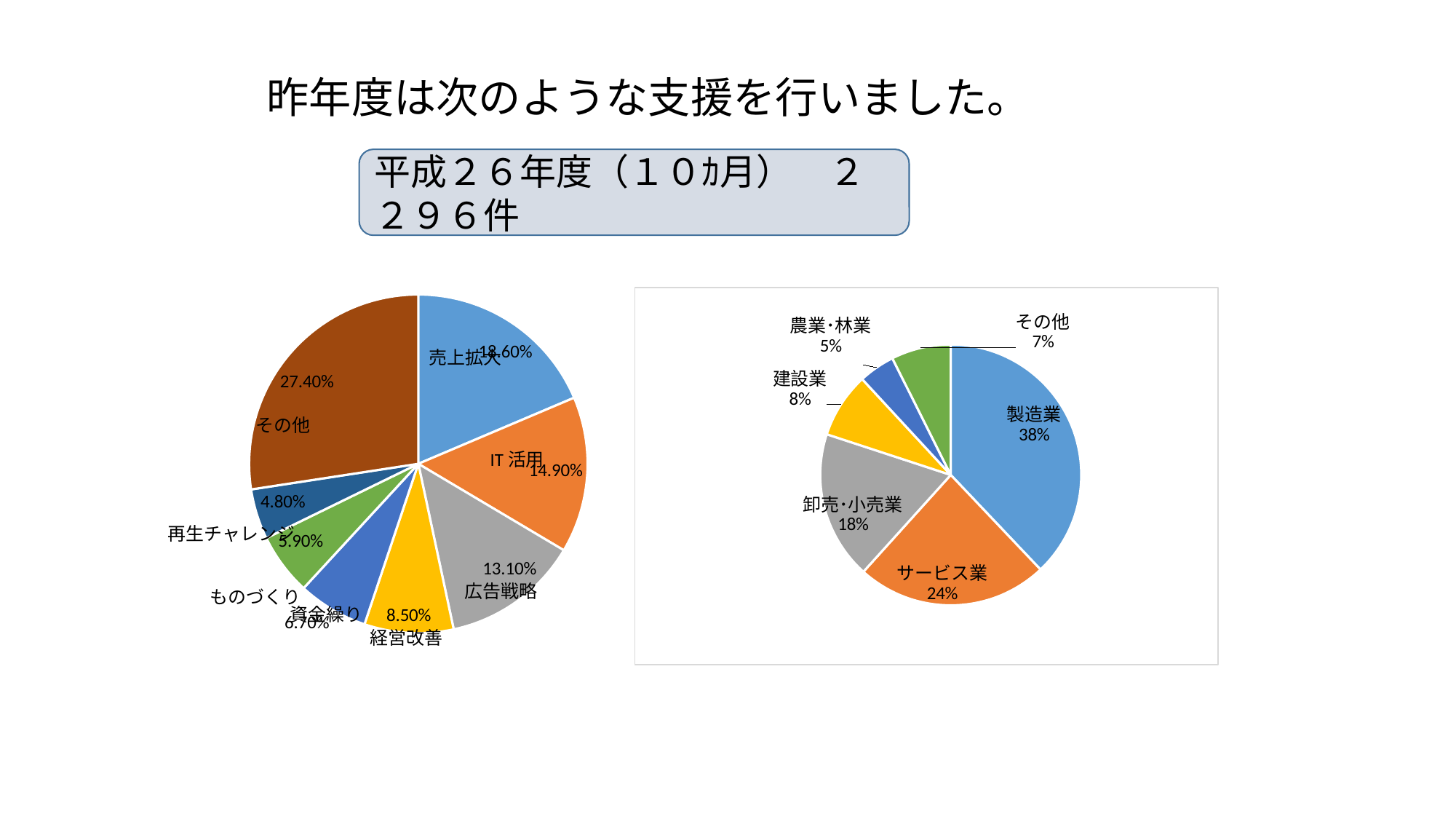
In the pie chart on the left, what percentage is shown for 売上拡大? 18.60% In the pie chart on the right, which category has the smallest share? 農業･林業 In the pie chart on the left, what is the difference between the shares of 広告戦略 and 資金繰り? 6.40% In the pie chart on the left, which category has the smallest share? 再生チャレンジ In the pie chart on the left, what percentage is shown for IT 活用? 14.90% In the pie chart on the right, what percentage is shown for 卸売･小売業? 18% In the pie chart on the right, which is larger, サービス業 or 建設業? サービス業 In the pie chart on the right, what percentage is shown for 製造業? 38% In the pie chart on the left, which category has the largest share? その他 In the pie chart on the left, what percentage is shown for 経営改善? 8.50% What kind of chart is the chart on the right? Pie chart In the pie chart on the left, how many slices are there? 8